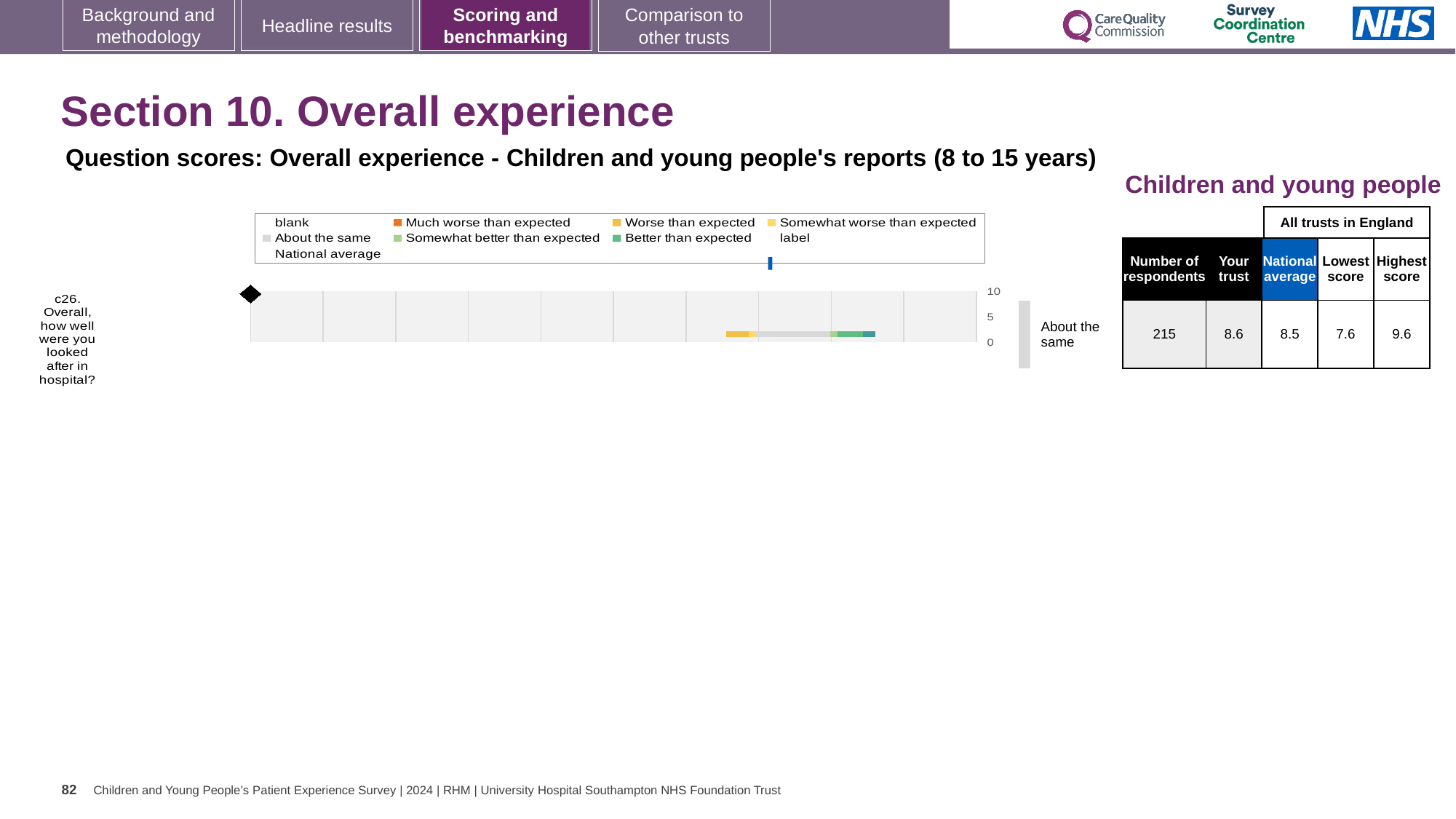
What is the highest value shown on the chart's score axis? 10 How many survey questions are plotted on the chart? 1 What kind of chart is shown on the slide? bar chart Which survey question is plotted on the chart? c26. Overall, how well were you looked after in hospital? What benchmark category label is shown to the right of the chart for question c26? About the same What is the highest score among all trusts in England for question c26? 9.6 What is the lowest score among all trusts in England for question c26? 7.6 What is the number of respondents for question c26? 215 Which is larger for question c26, the 'Your trust' score or the national average? Your trust What is the 'Your trust' score for question c26? 8.6 What is the difference between the 'Your trust' score and the national average for question c26? 0.1 What is the national average score for question c26? 8.5